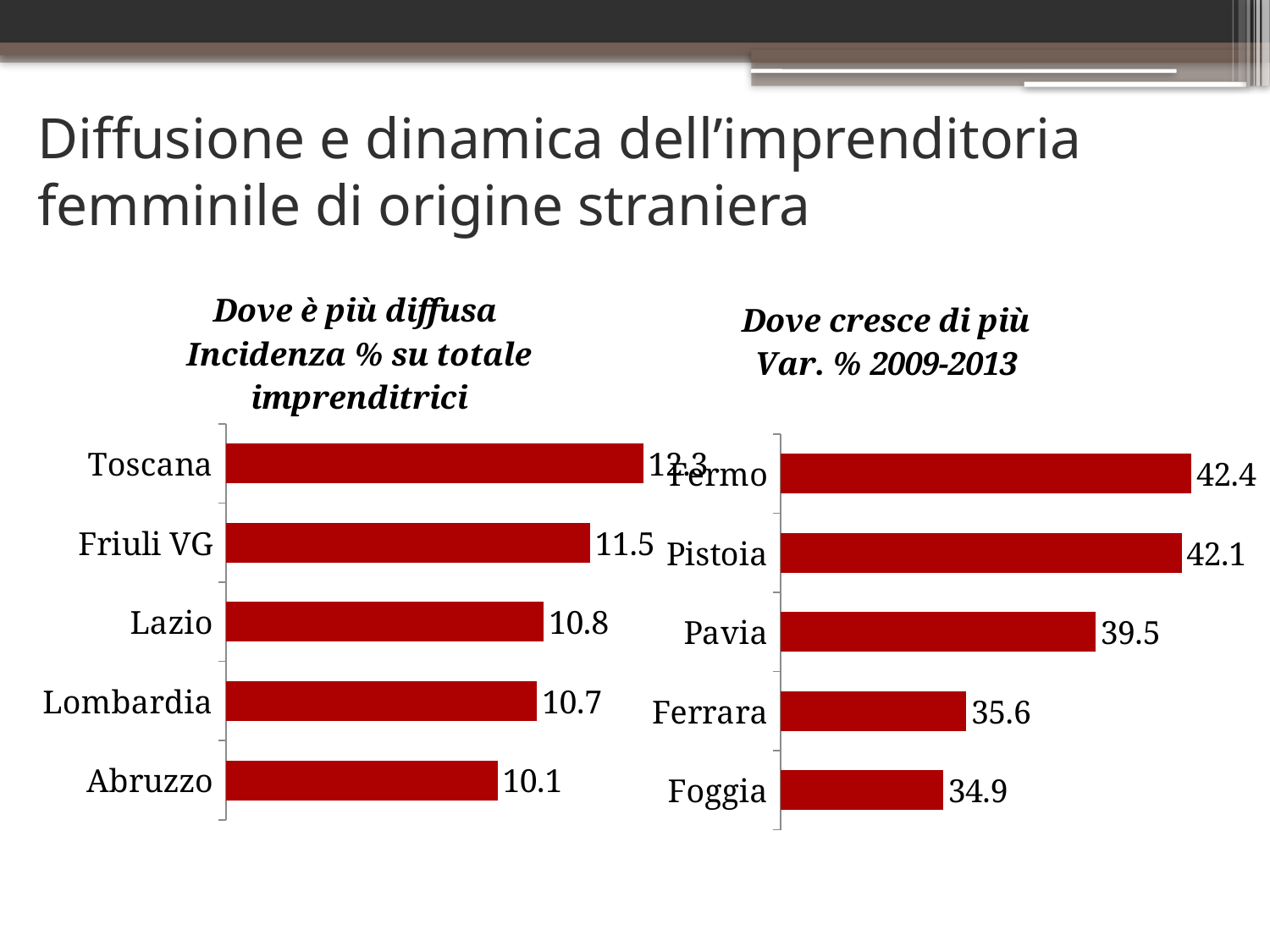
In the left chart (Dove è più diffusa), which region has the highest value? Toscana In the left chart (Dove è più diffusa), what is the difference between the values for Friuli VG and Abruzzo? 1.4 What type of chart is the right chart (Dove cresce di più)? Bar chart In the right chart (Dove cresce di più), what is the value for Pavia? 39.5 In the left chart (Dove è più diffusa), which region has the lowest value? Abruzzo In the right chart (Dove cresce di più), which province has the lowest value? Foggia In the right chart (Dove cresce di più), what is the difference between the values for Pavia and Foggia? 4.6 In the left chart (Dove è più diffusa), what is the value for Friuli VG? 11.5 In the left chart (Dove è più diffusa), how many regions are shown? 5 In the right chart (Dove cresce di più), which is larger, the value for Pavia or the value for Ferrara? Pavia In the right chart (Dove cresce di più), what is the value for Ferrara? 35.6 In the left chart (Dove è più diffusa), what is the value for Abruzzo? 10.1